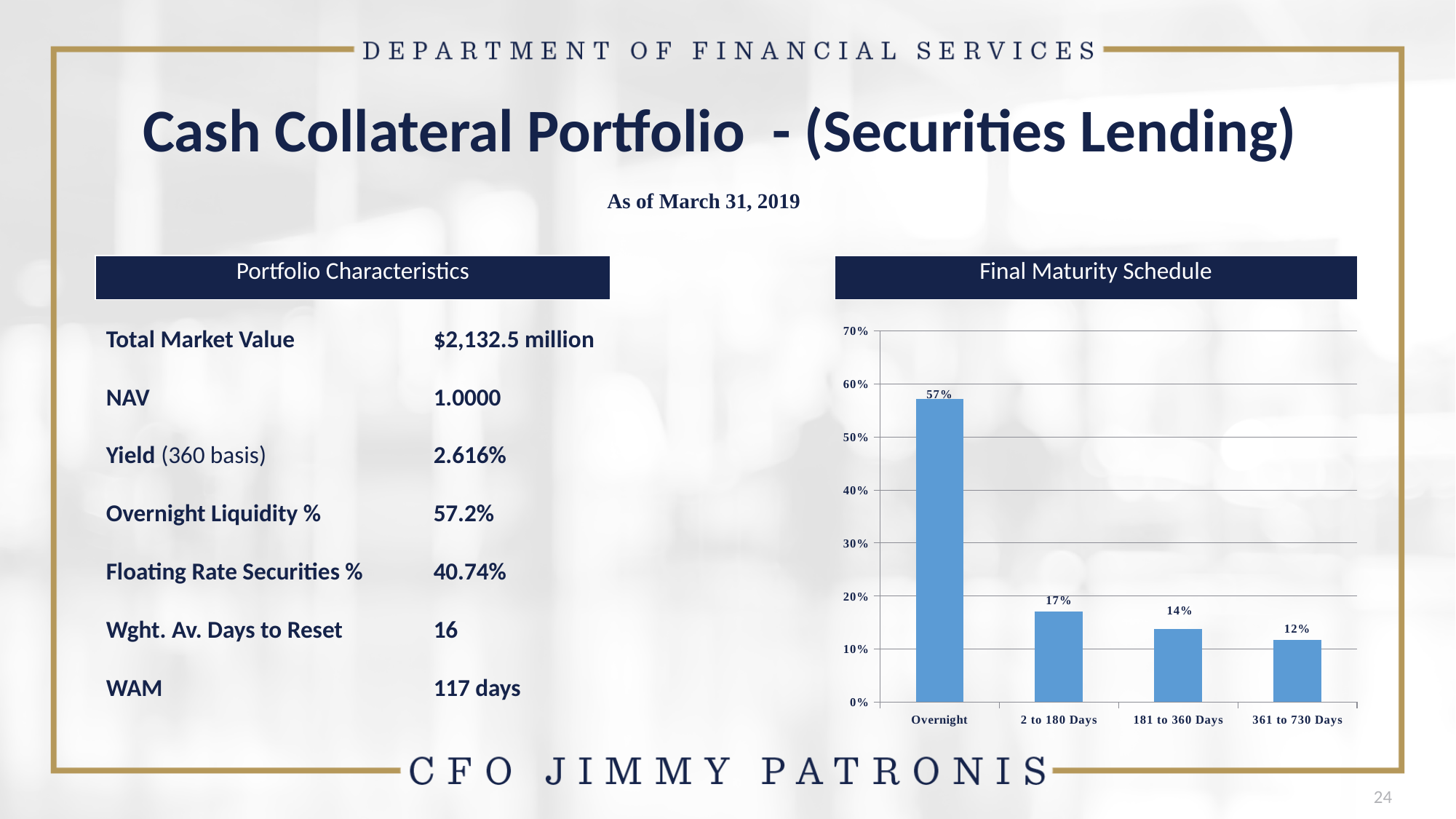
What is the value for 181 to 360 Days in the Final Maturity Schedule chart? 14% Which is larger in the Final Maturity Schedule chart: 181 to 360 Days or 361 to 730 Days? 181 to 360 Days What kind of chart is the Final Maturity Schedule? Bar chart What is the value for 361 to 730 Days in the Final Maturity Schedule chart? 12% Is the value for Overnight in the Final Maturity Schedule chart greater or less than 50%? greater How many maturity buckets are shown in the Final Maturity Schedule chart? 4 Which maturity bucket has the lowest value in the Final Maturity Schedule chart? 361 to 730 Days What is the difference between the Overnight and 2 to 180 Days values in the Final Maturity Schedule chart? 40% Do the values in the Final Maturity Schedule chart rise or fall from Overnight to 361 to 730 Days? Fall What is the value for 2 to 180 Days in the Final Maturity Schedule chart? 17% What is the value for Overnight in the Final Maturity Schedule chart? 57% Which maturity bucket has the highest value in the Final Maturity Schedule chart? Overnight